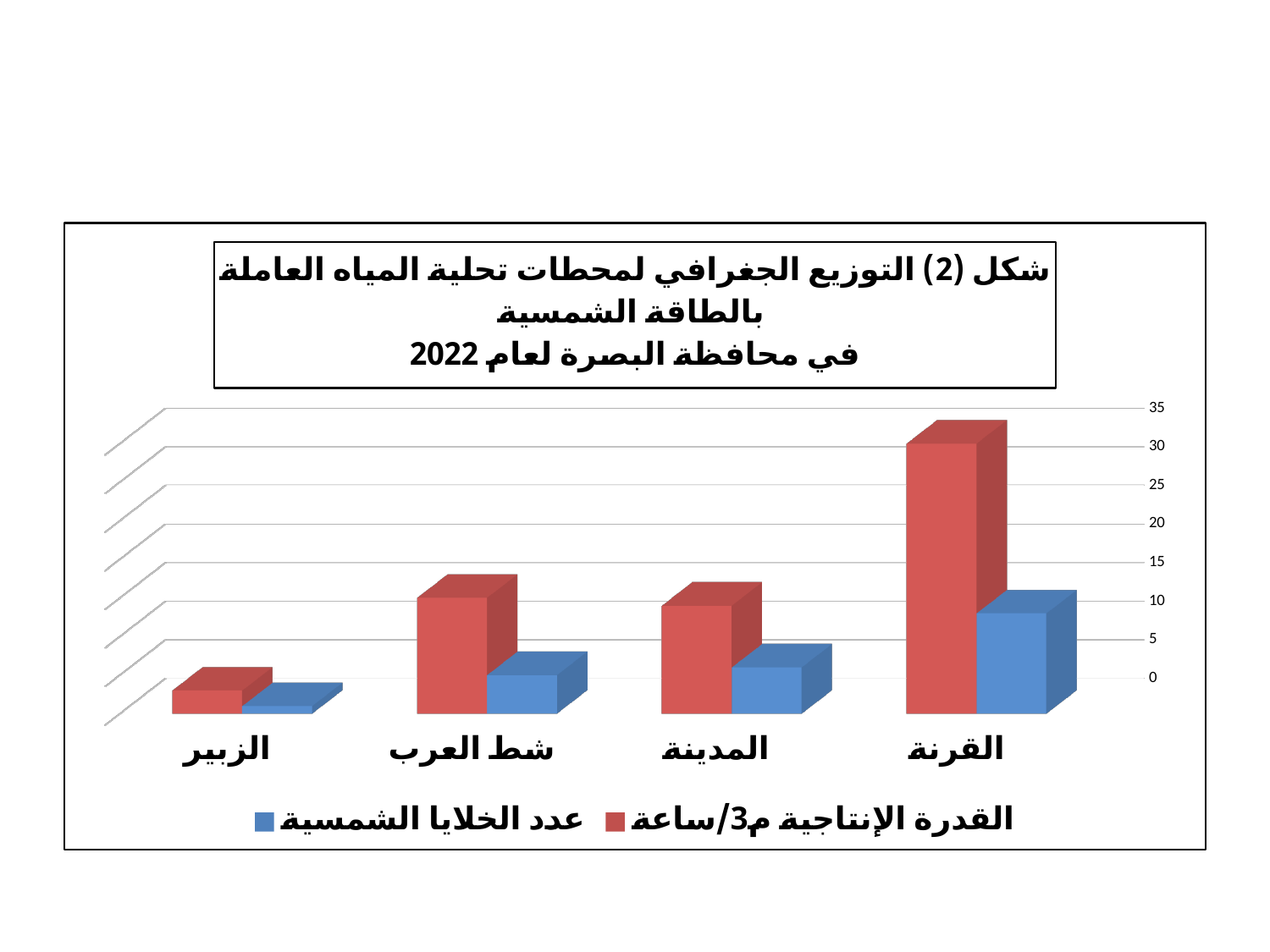
Is the value of القدرة الإنتاجية م3/ساعة for الزبير greater or less than 5? less Which category has the lowest value for القدرة الإنتاجية م3/ساعة? الزبير Which is larger, the القدرة الإنتاجية م3/ساعة value for القرنة or for شط العرب? القرنة How many categories (governorate districts) are shown on the x axis? 4 How many series does the legend list? 2 Which category has the highest value for عدد الخلايا الشمسية? القرنة Which category has the highest value for القدرة الإنتاجية م3/ساعة? القرنة Is the value of عدد الخلايا الشمسية for القرنة greater or less than 15? less Is the value of القدرة الإنتاجية م3/ساعة for القرنة greater or less than 25? greater What kind of chart is shown on the slide? bar chart Which colour represents the series عدد الخلايا الشمسية in the legend? blue